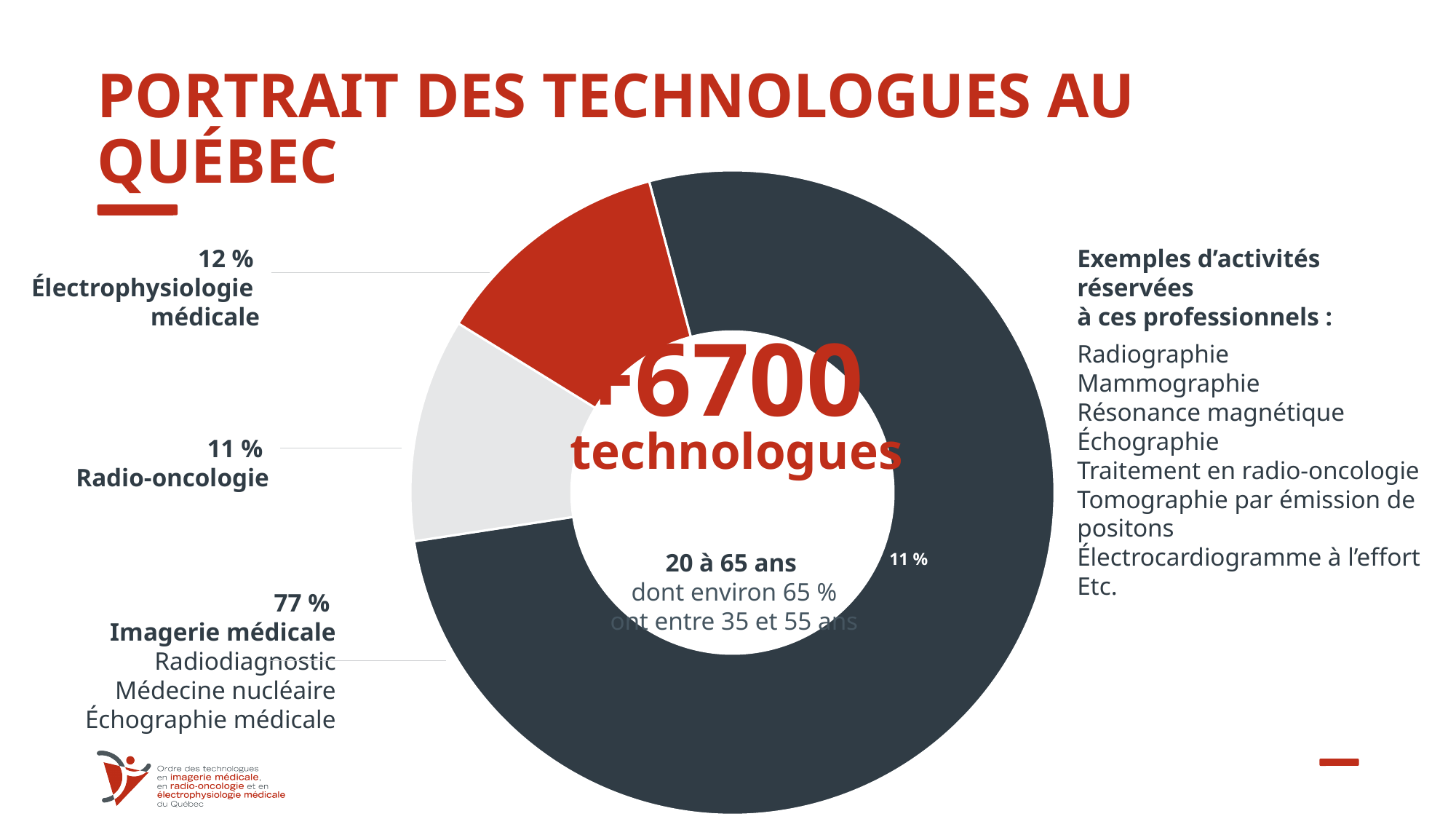
Which category has the largest share of the donut chart? Imagerie médicale What colour is the Électrophysiologie médicale slice? Red Which category has the smallest share of the donut chart? Radio-oncologie What is the difference in percentage points between Électrophysiologie médicale and Radio-oncologie? 1 What percentage of technologues work in Radio-oncologie? 11 % What number of technologues is shown in the centre of the donut chart? +6700 How many categories are shown in the donut chart? 3 What is the difference in percentage points between Imagerie médicale and Électrophysiologie médicale? 65 What is the combined share of Radio-oncologie and Électrophysiologie médicale? 23 % What percentage of technologues work in Électrophysiologie médicale? 12 % What kind of chart is shown on the slide? Donut (pie) chart What percentage of technologues work in Imagerie médicale? 77 %